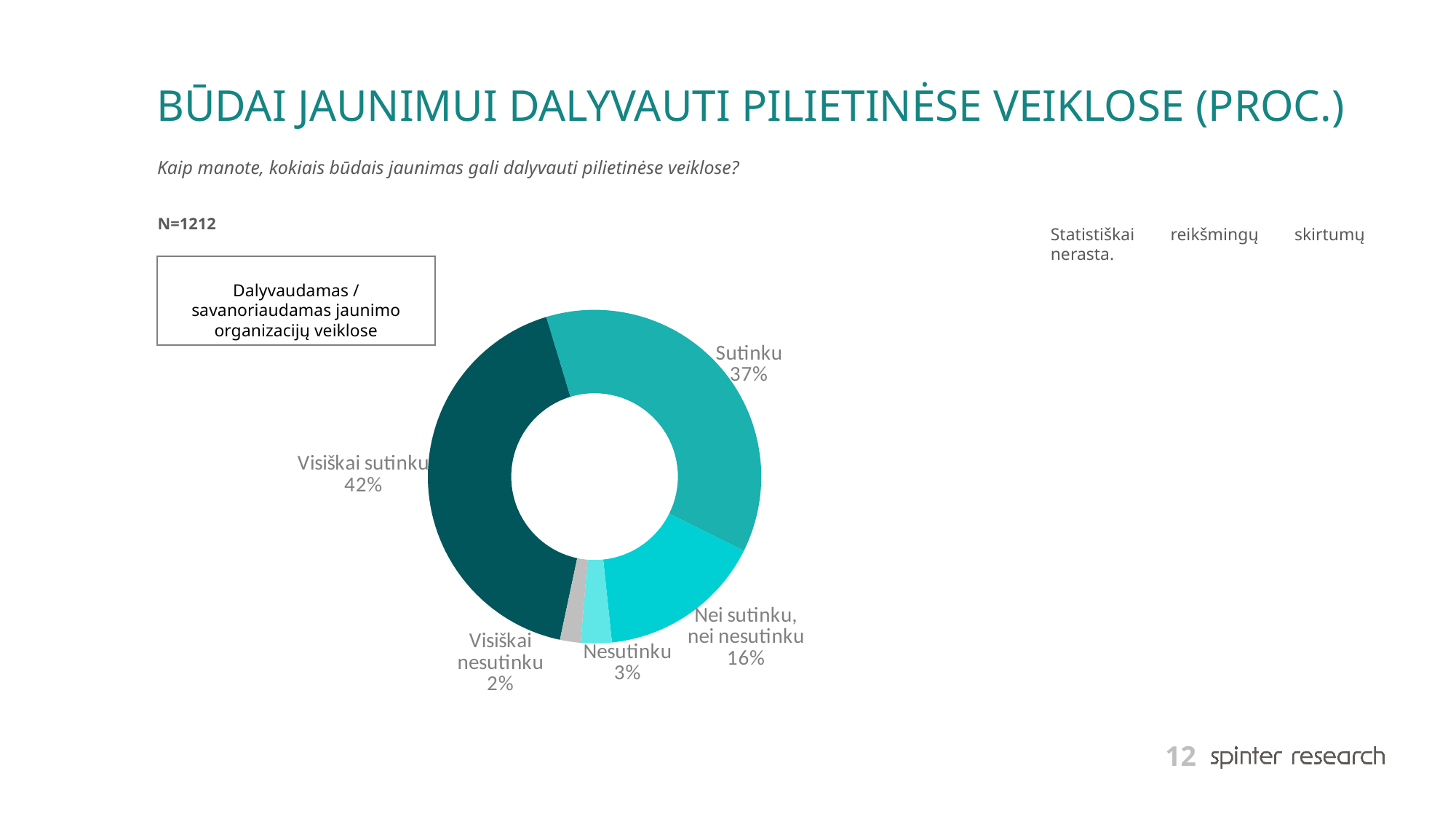
Which is larger: the share for "Nei sutinku, nei nesutinku" or the share for "Nesutinku"? Nei sutinku, nei nesutinku Which response category has the smallest share of the chart? Visiškai nesutinku What percentage of respondents answered "Nei sutinku, nei nesutinku"? 16% What is the sample size (N) stated on the slide? N=1212 What percentage of respondents answered "Visiškai sutinku"? 42% Which response category has the largest share of the chart? Visiškai sutinku What kind of chart is shown on the slide? Pie chart (doughnut) What percentage of respondents answered "Visiškai nesutinku"? 2% What percentage of respondents answered "Sutinku"? 37% What is the difference in percentage points between "Visiškai sutinku" and "Sutinku"? 5 What percentage of respondents answered "Nesutinku"? 3% How many response categories are shown in the chart? 5